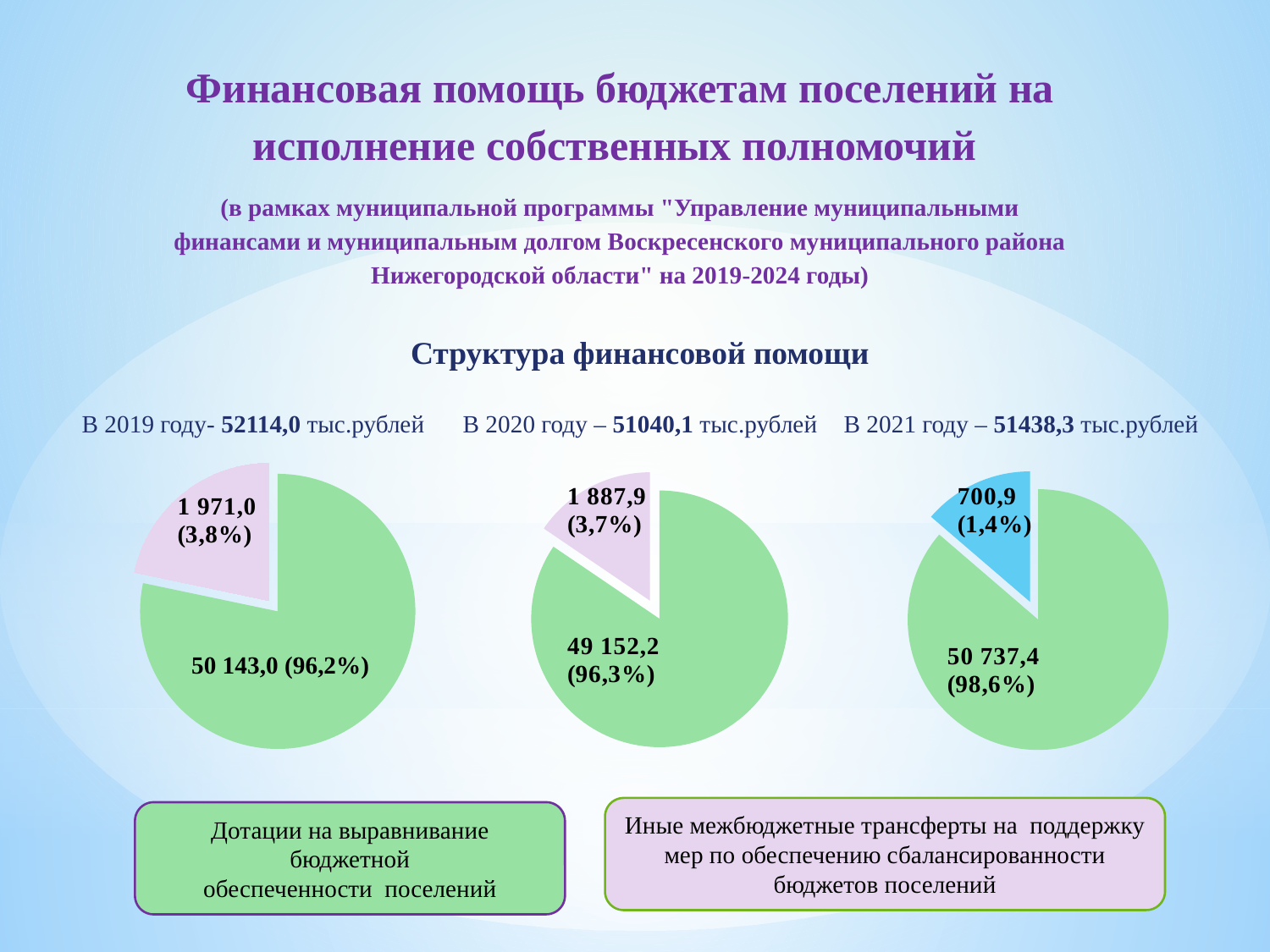
Сколько круговых диаграмм показано на слайде? 3 На сколько иные межбюджетные трансферты в 2019 году (1 971,0) больше, чем в 2021 году (700,9)? 1 270,1 В каком году иные межбюджетные трансферты были наибольшими по значению? 2019 В каком году иные межбюджетные трансферты были наименьшими по значению? 2021 На диаграмме за 2019 год какое значение указано для дотаций на выравнивание бюджетной обеспеченности поселений (зелёный сектор)? 50 143,0 (96,2%) Сколько секторов в круговой диаграмме за 2019 год? 2 На диаграмме за 2020 год какое значение указано для иных межбюджетных трансфертов (малый сектор)? 1 887,9 Какой тип диаграмм используется на слайде в разделе «Структура финансовой помощи»? Круговые диаграммы На диаграмме за 2019 год какую долю составляют иные межбюджетные трансферты? 3,8% Что больше: иные межбюджетные трансферты в 2020 году или в 2021 году? В 2020 году Какой общий объём финансовой помощи указан для 2020 года? 51040,1 тыс.рублей На диаграмме за 2021 год какую долю составляют иные межбюджетные трансферты? 1,4%